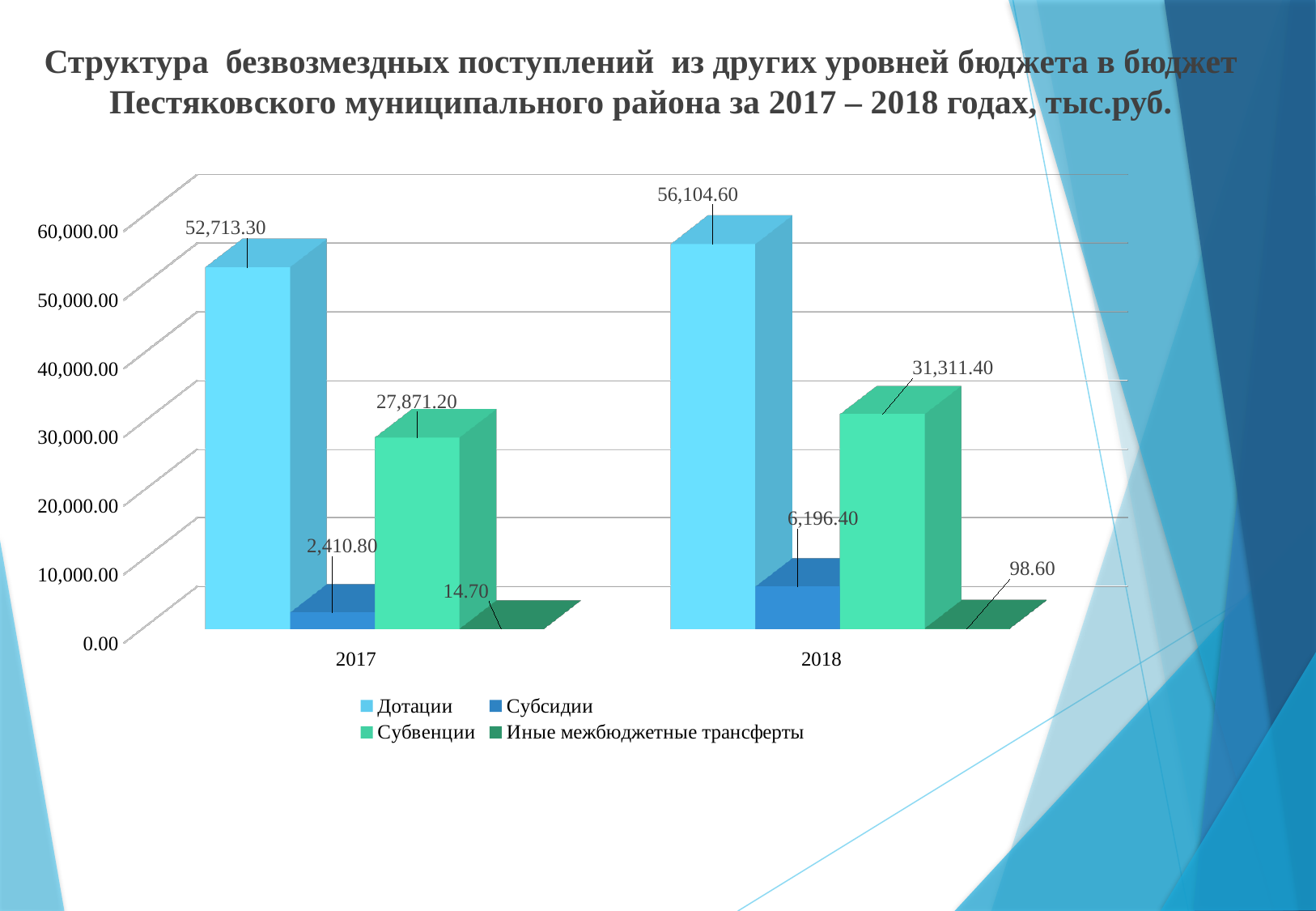
What is the difference between the Субсидии values for 2018 and 2017? 3,785.60 Which series has the highest value in 2018? Дотации What kind of chart is shown on the slide? Bar chart What is the value for Субвенции in 2018? 31,311.40 What is the value for Субсидии in 2018? 6,196.40 What is the difference between the Дотации values for 2018 and 2017? 3,391.30 Which is larger: Субвенции in 2017 or Субвенции in 2018? Субвенции in 2018 What is the value for Дотации in 2017? 52,713.30 How many series does the legend list? 4 Do the Дотации values rise or fall from 2017 to 2018? Rise Which series has the lowest value in 2017? Иные межбюджетные трансферты What is the value for Иные межбюджетные трансферты in 2017? 14.70